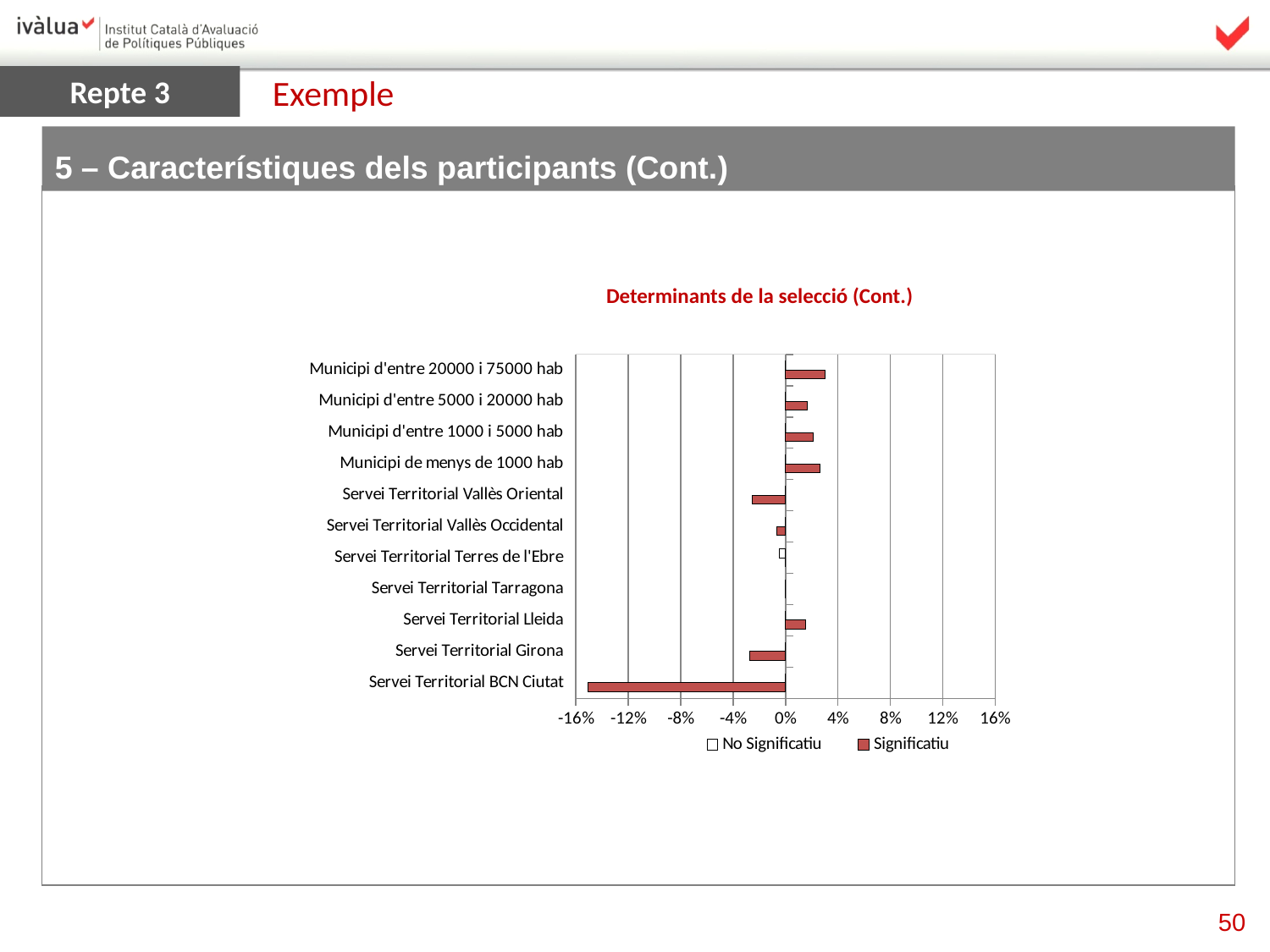
Is the value for Servei Territorial Vallès Oriental greater or less than 0%? less Is the value for Servei Territorial Girona greater or less than -4%? greater How many series does the legend list? 2 How many categories are plotted on the chart? 11 What kind of chart is shown on the slide? bar chart What is the title of the chart? Determinants de la selecció (Cont.) Which is larger, the value for Servei Territorial BCN Ciutat or the value for Servei Territorial Vallès Oriental? Servei Territorial Vallès Oriental Is the value for Servei Territorial BCN Ciutat greater or less than -12%? less Which is larger, the value for Servei Territorial Lleida or the value for Servei Territorial Girona? Servei Territorial Lleida Which series does the bar for Servei Territorial Terres de l'Ebre belong to? No Significatiu Which category has the lowest value on the chart? Servei Territorial BCN Ciutat